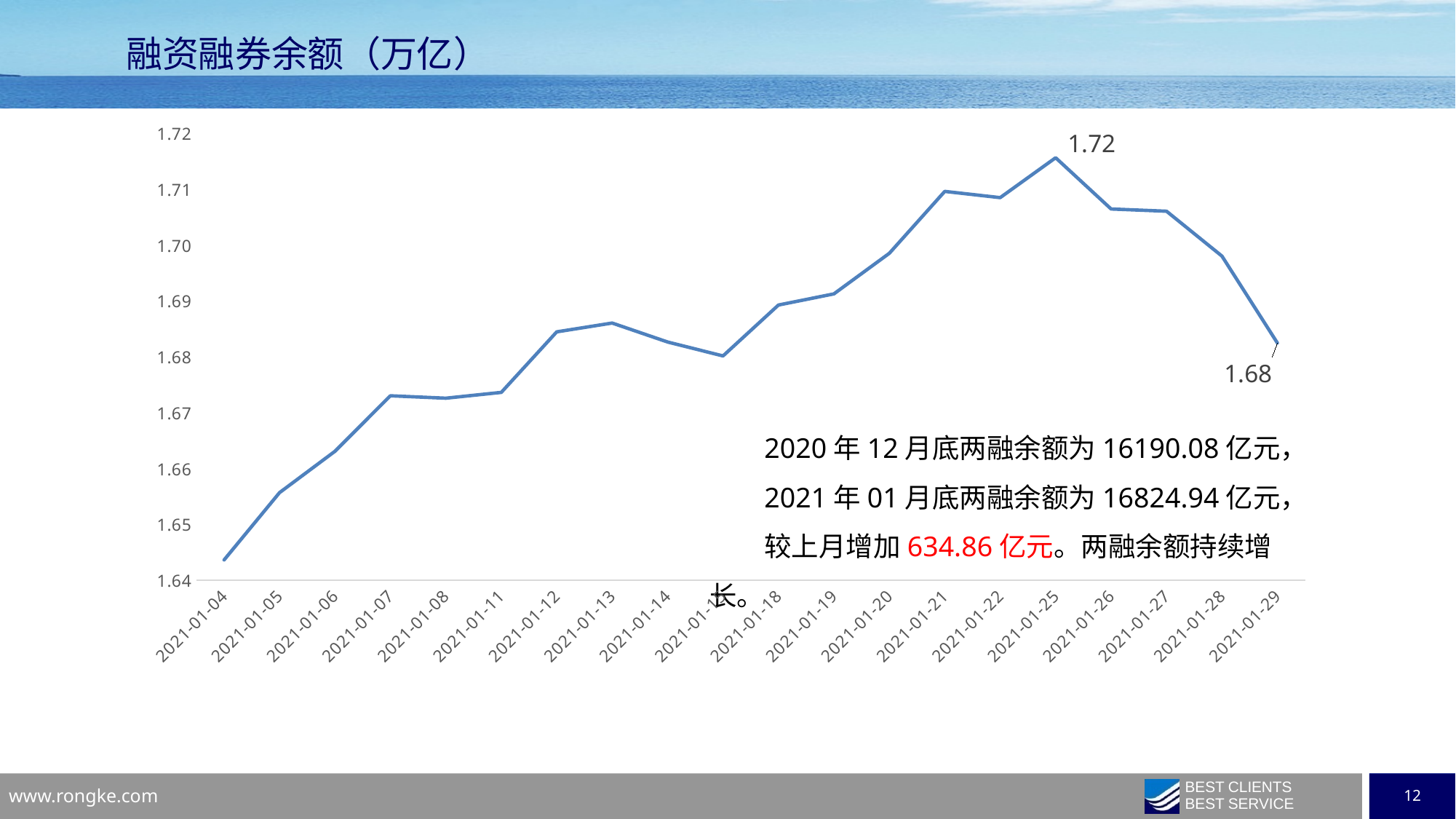
Which is larger, the value for 2021-01-25 or the value for 2021-01-29? 2021-01-25 What is the difference between the value for 2021-01-25 and the value for 2021-01-29? 0.04 Which is larger, the value for 2021-01-21 or the value for 2021-01-12? 2021-01-21 What is the value for 2021-01-25? 1.72 On which date is the value lowest? 2021-01-04 Is the value for 2021-01-21 greater or less than 1.70? greater How many dates are plotted on the x axis? 20 What is the title of the chart? 融资融券余额（万亿） Is the value for 2021-01-04 greater or less than 1.65? less What is the value for 2021-01-29? 1.68 On which date is the value highest? 2021-01-25 What kind of chart is shown on the slide? line chart